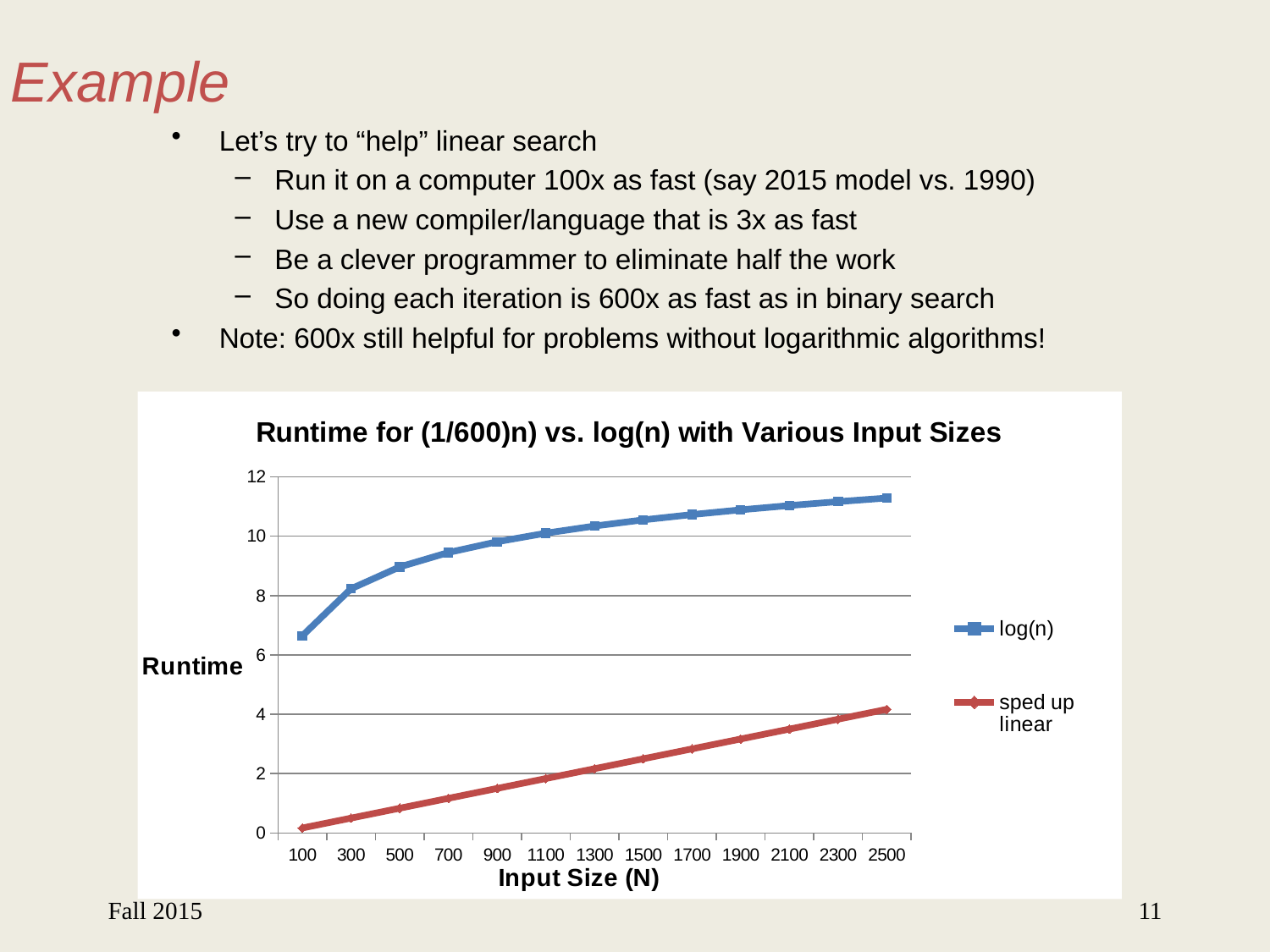
What kind of chart is shown on the slide? line chart Is the value of log(n) at input size 100 greater or less than 6? greater At which input size does the sped up linear series have its lowest value? 100 How many series does the legend list? 2 Is the value of log(n) at input size 2500 greater or less than 10? greater At input size 2500, which series has the larger runtime, log(n) or sped up linear? log(n) Is the value of sped up linear at input size 100 greater or less than 2? less What is the title of the chart? Runtime for (1/600)n) vs. log(n) with Various Input Sizes What is the label of the x axis? Input Size (N) Does the log(n) series rise or fall as input size increases? rise Does the sped up linear series rise or fall as input size increases? rise How many input sizes are plotted along the x axis? 13